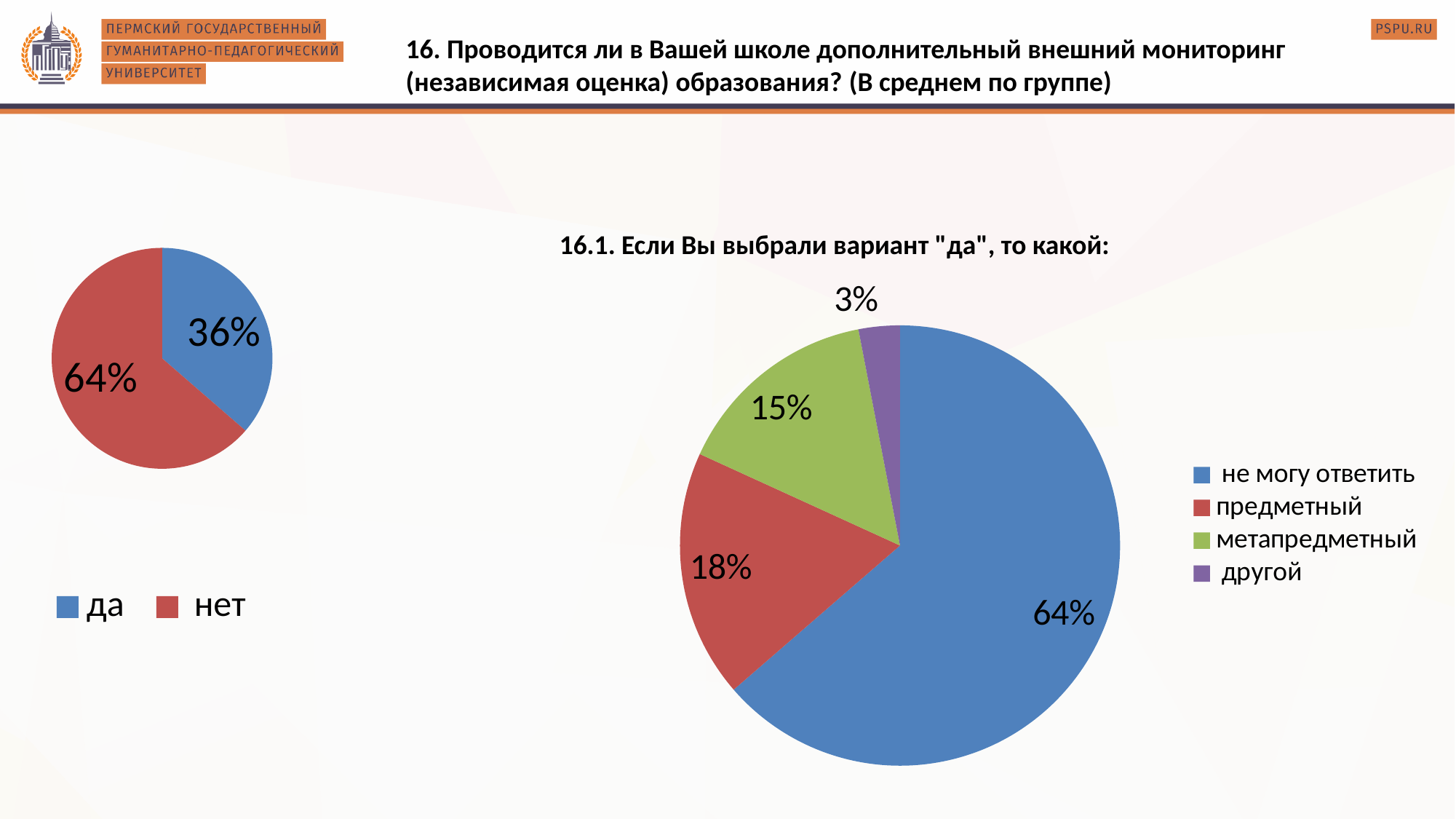
In the right pie chart (16.1), what share is labelled for "не могу ответить"? 64% In the right pie chart (16.1), which category has the smallest share? другой In the left pie chart, what share of respondents answered "нет"? 64% In the right pie chart (16.1), what share is labelled for "предметный"? 18% In the left pie chart, how many series does the legend list? 2 What type of chart is used on the right side of the slide (16.1)? pie chart In the right pie chart (16.1), which category has the largest share? не могу ответить In the right pie chart (16.1), how many categories does the legend list? 4 In the left pie chart, what is the difference between the shares for "нет" and "да"? 28% In the left pie chart, what share of respondents answered "да"? 36% In the left pie chart, which answer has the larger share, "да" or "нет"? нет In the right pie chart (16.1), what share is labelled for "метапредметный"? 15%